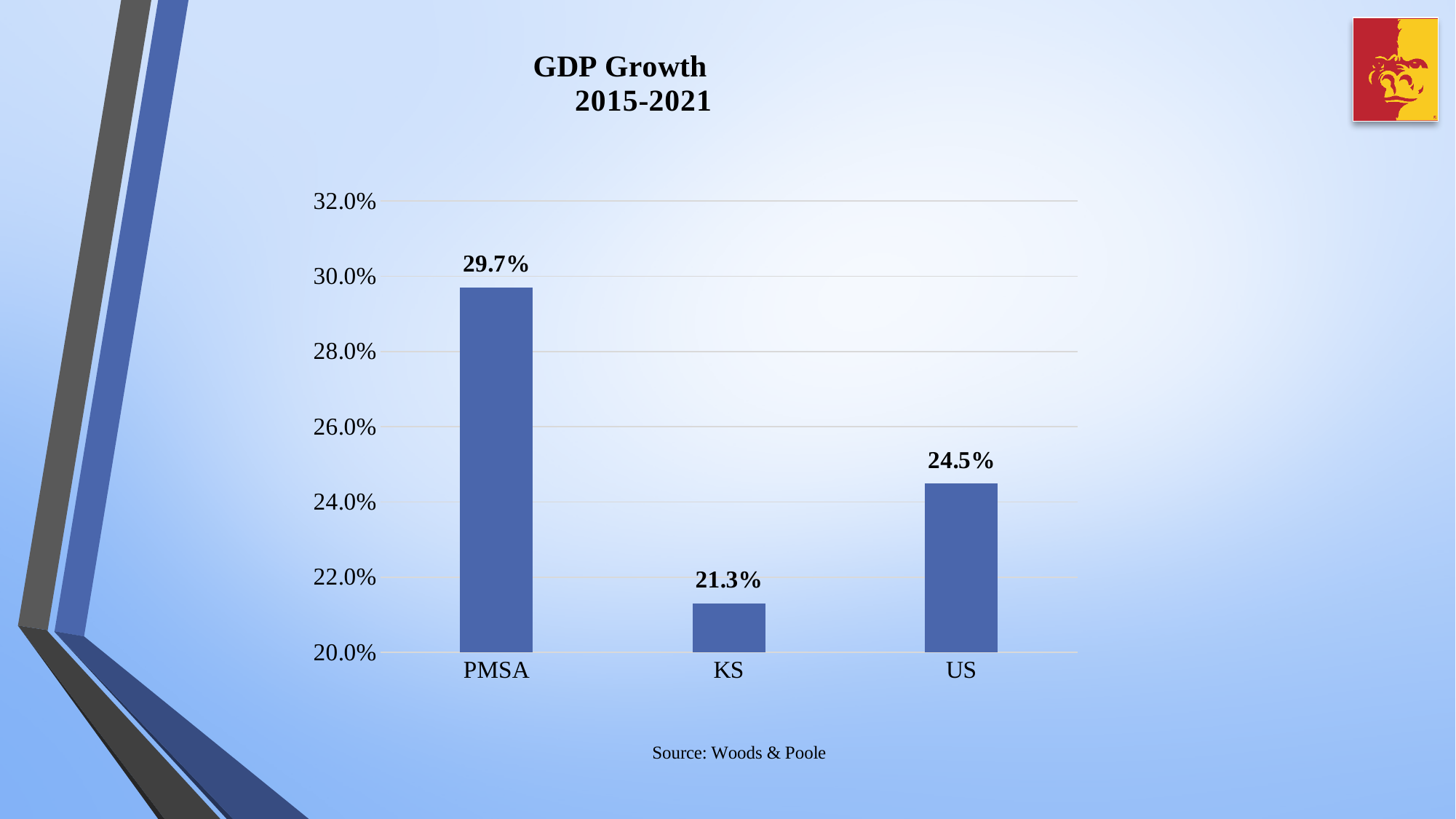
Which category has the highest GDP growth? PMSA What is the GDP growth value for PMSA? 29.7% Which has higher GDP growth, KS or US? US What is the title of the chart? GDP Growth 2015-2021 What is the difference in GDP growth between PMSA and US? 5.2% How many categories are shown in the chart? 3 What kind of chart is shown on the slide? Bar chart What is the difference in GDP growth between PMSA and KS? 8.4% Which category has the lowest GDP growth? KS What is the GDP growth value for KS? 21.3% What is the GDP growth value for US? 24.5% Is the GDP growth value for US greater or less than 26.0%? less